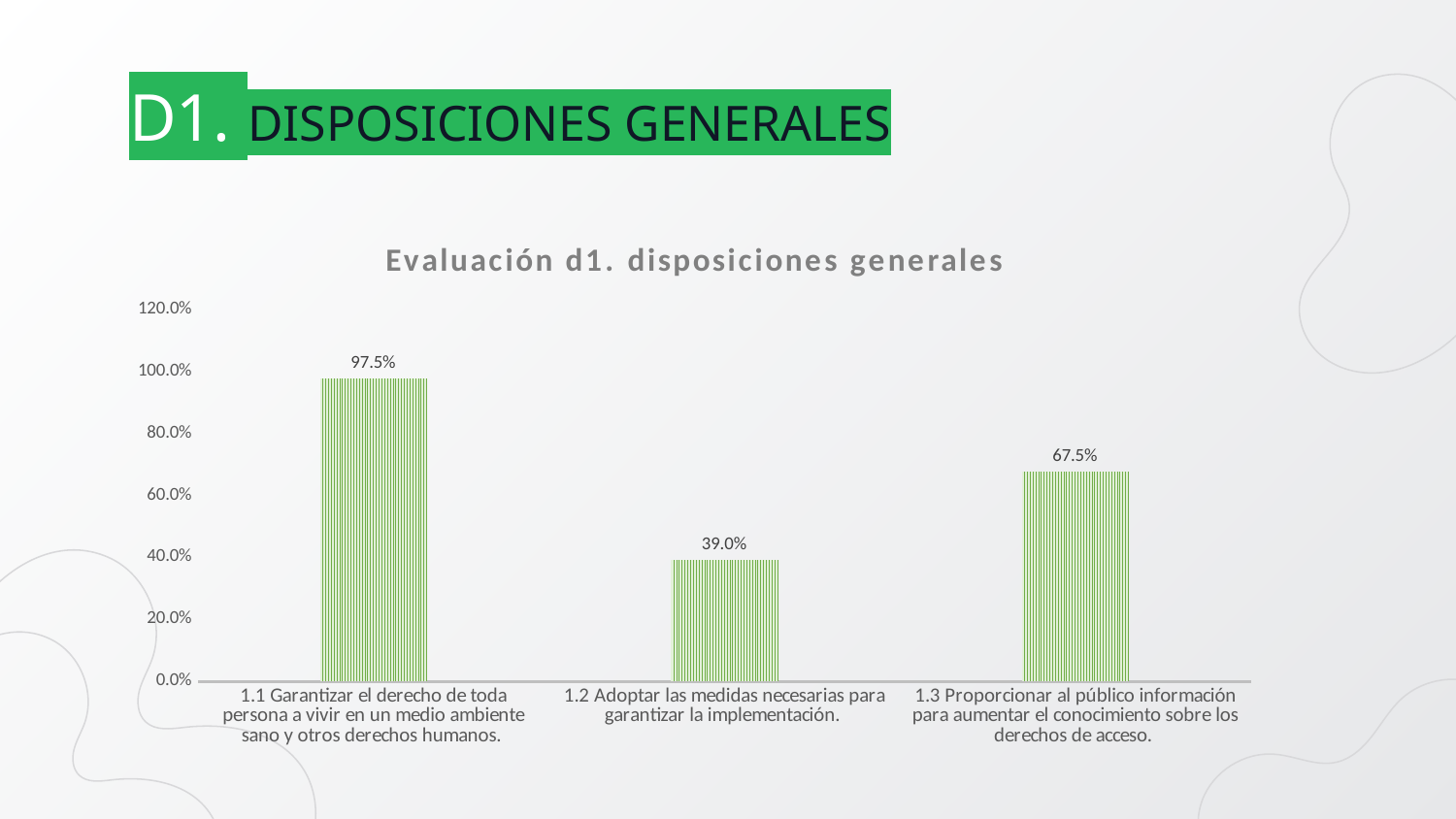
What is the title of the chart? Evaluación d1. disposiciones generales Which is larger, the value for category 1.3 or the value for category 1.2? 1.3 Proporcionar al público información para aumentar el conocimiento sobre los derechos de acceso. What kind of chart is shown on the slide? Bar chart Which category has the lowest value? 1.2 Adoptar las medidas necesarias para garantizar la implementación. What is the value for category 1.3 (Proporcionar al público información para aumentar el conocimiento sobre los derechos de acceso)? 67.5% What is the difference between the values for category 1.3 and category 1.2? 28.5% What is the value for category 1.1 (Garantizar el derecho de toda persona a vivir en un medio ambiente sano y otros derechos humanos)? 97.5% Is the value for category 1.3 greater or less than 60.0%? greater What is the value for category 1.2 (Adoptar las medidas necesarias para garantizar la implementación)? 39.0% How many categories are shown in the chart? 3 What is the difference between the values for category 1.1 and category 1.2? 58.5% Which category has the highest value? 1.1 Garantizar el derecho de toda persona a vivir en un medio ambiente sano y otros derechos humanos.